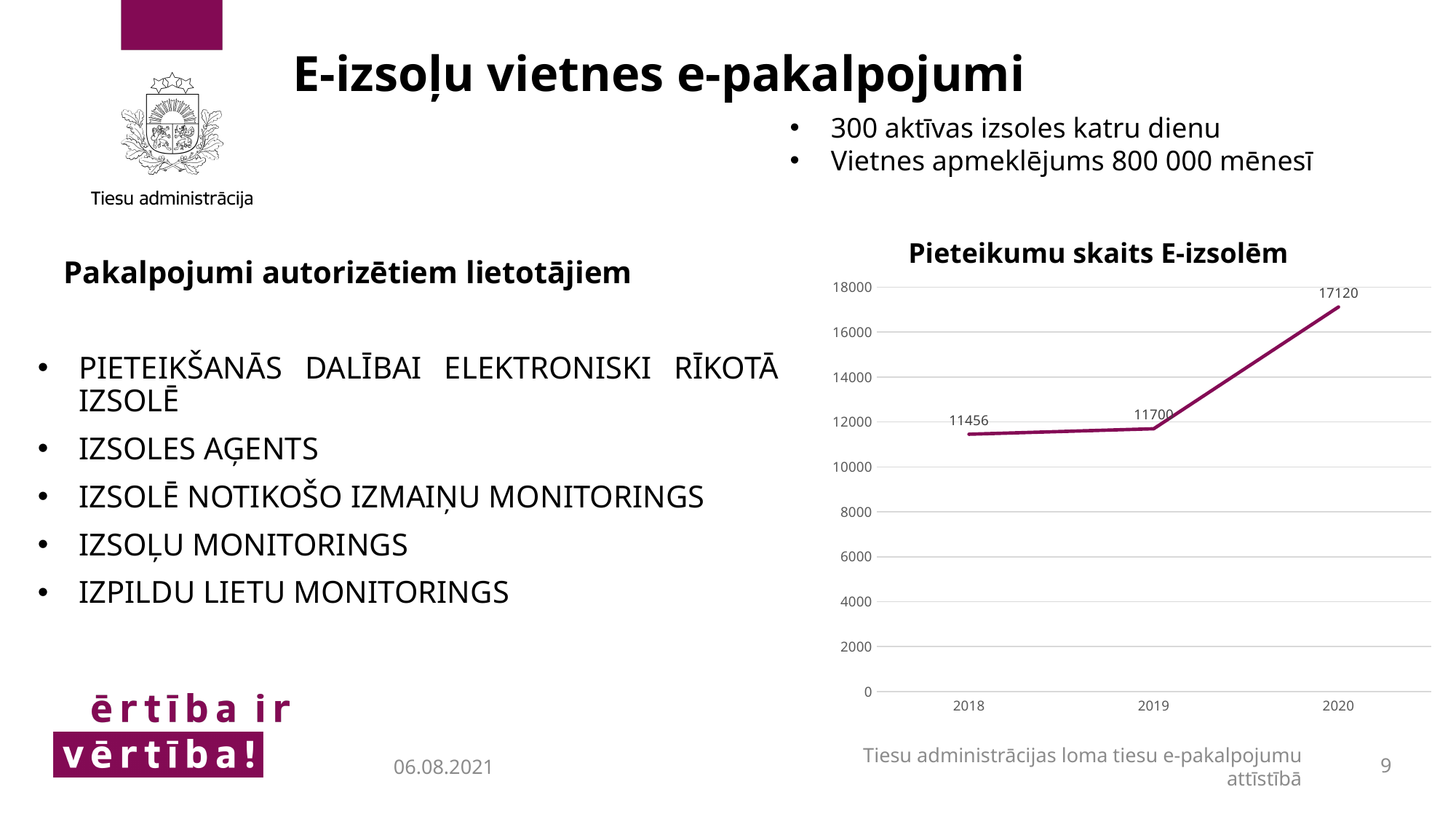
What is the value for 2018 in the chart? 11456 Which year has the highest value in the chart? 2020 What is the title of the chart? Pieteikumu skaits E-izsolēm How many years are plotted in the chart? 3 What kind of chart is shown on the slide? line chart Which year has the lowest value in the chart? 2018 What is the difference between the values for 2020 and 2019? 5420 What is the difference between the values for 2019 and 2018? 244 What is the value for 2020 in the chart? 17120 Which is larger, the value for 2020 or the value for 2018? 2020 Is the value for 2020 greater or less than 16000? greater What is the value for 2019 in the chart? 11700